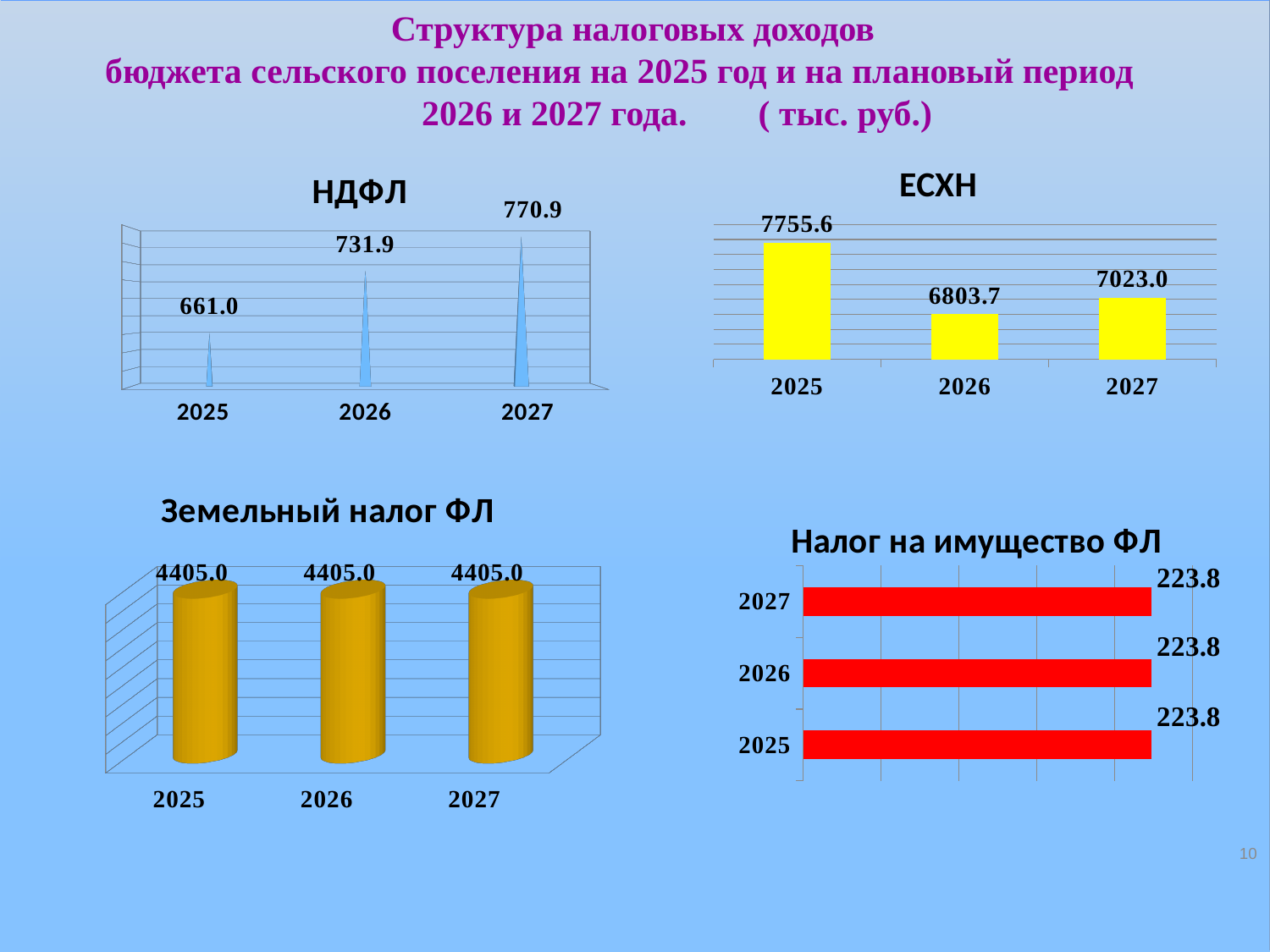
In the ЕСХН chart, which is larger, the value for 2026 or the value for 2027? 2027 In the Налог на имущество ФЛ chart, what is the value for 2025? 223.8 In the ЕСХН chart, what is the value for 2025? 7755.6 In the НДФЛ chart, what is the difference between the 2027 and 2025 values? 109.9 How many years are shown in the Земельный налог ФЛ chart? 3 In the Земельный налог ФЛ chart, what is the value for 2027? 4405.0 In the ЕСХН chart, which year has the highest value? 2025 In the ЕСХН chart, what is the difference between the 2025 and 2026 values? 951.9 In the НДФЛ chart, do the values rise or fall from 2025 to 2027? rise In the НДФЛ chart, what is the value for 2026? 731.9 In the НДФЛ chart, which year has the lowest value? 2025 What type of chart is the Налог на имущество ФЛ chart? bar chart